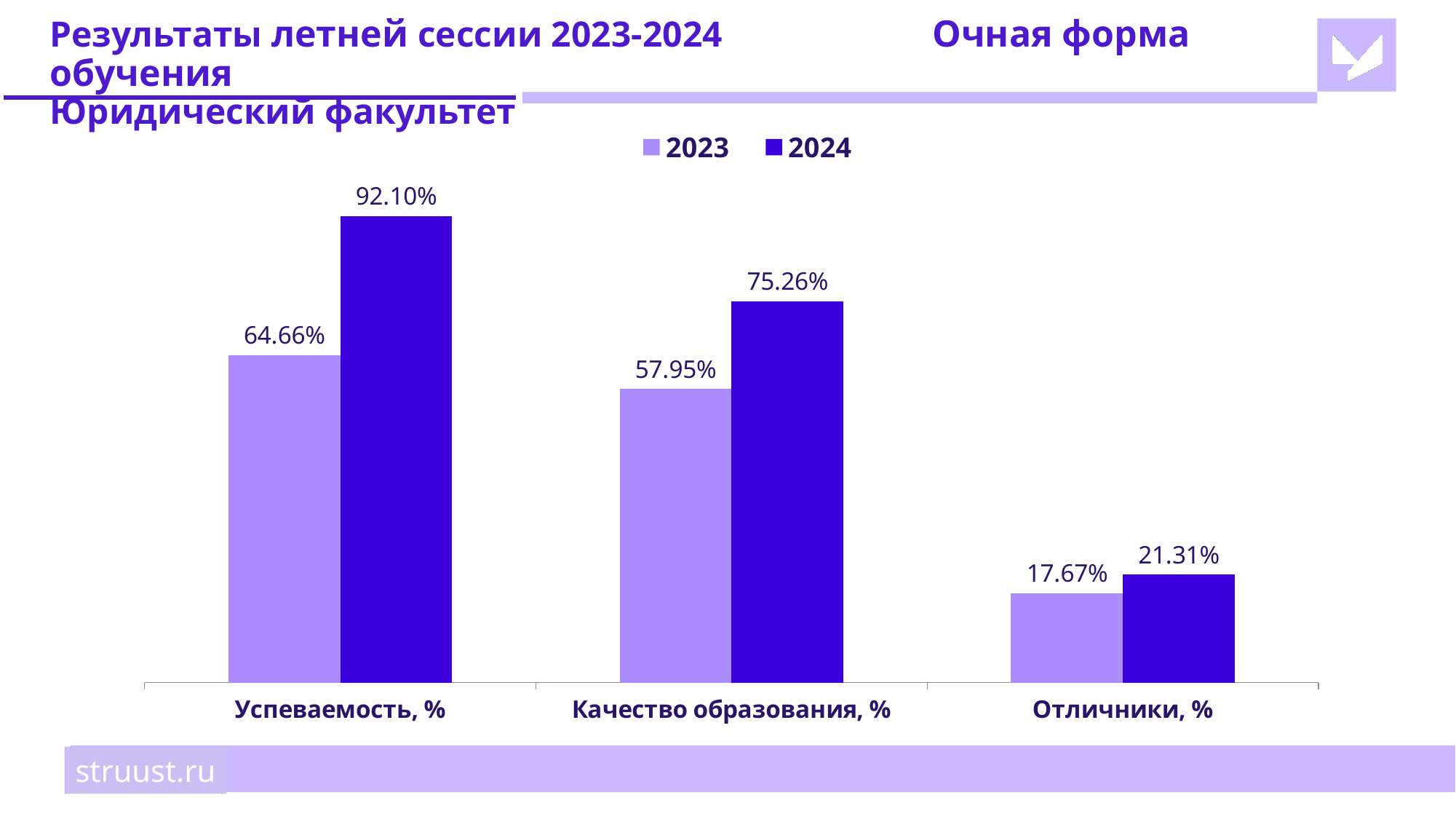
Which is larger for Отличники, %: the 2023 value or the 2024 value? 2024 Which category has the lowest value in the 2023 series? Отличники, % How many series does the legend list? 2 What is the difference between the 2024 and 2023 values for Успеваемость, %? 27.44% How many categories are shown on the x axis? 3 What kind of chart is shown on the slide? Bar chart What is the difference between the 2024 and 2023 values for Качество образования, %? 17.31% What is the value for Отличники, % in 2024? 21.31% What is the value for Успеваемость, % in 2023? 64.66% What is the value for Успеваемость, % in 2024? 92.10% What is the value for Качество образования, % in 2023? 57.95% Which category has the highest value in the 2024 series? Успеваемость, %